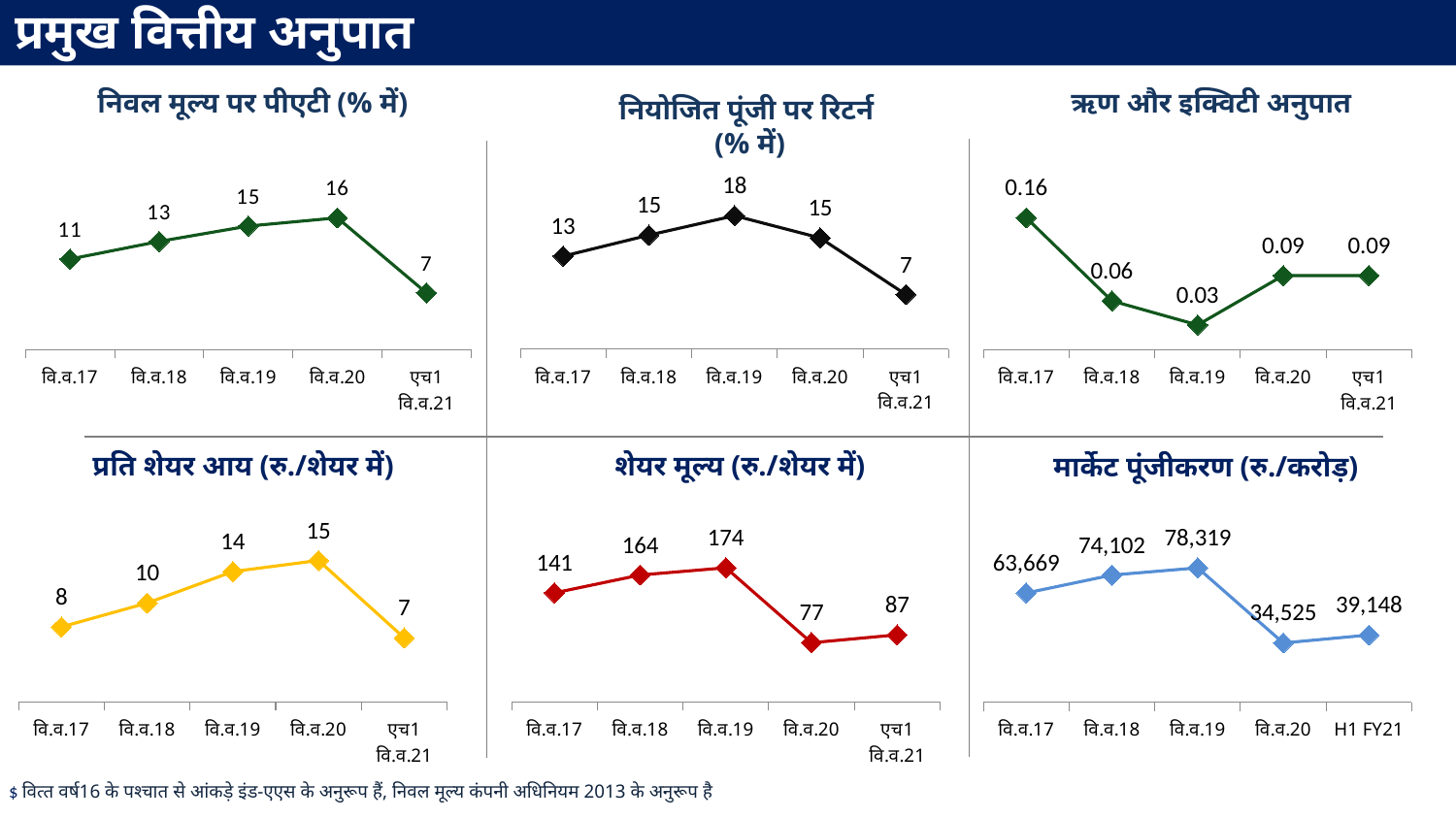
In the 'नियोजित पूंजी पर रिटर्न (% में)' chart, do the values rise or fall from वि.व.17 to वि.व.19? Rise In the 'शेयर मूल्य (रु./शेयर में)' chart, what is the value for वि.व.19? 174 In the 'नियोजित पूंजी पर रिटर्न (% में)' chart, which period has the highest value? वि.व.19 In the 'ऋण और इक्विटी अनुपात' chart, what is the value for वि.व.17? 0.16 What type of chart is the 'निवल मूल्य पर पीएटी (% में)' chart? Line chart In the 'मार्केट पूंजीकरण (रु./करोड़)' chart, what is the value for वि.व.19? 78,319 How many data points are plotted in the 'प्रति शेयर आय (रु./शेयर में)' chart? 5 In the 'शेयर मूल्य (रु./शेयर में)' chart, which is larger, the value for वि.व.20 or एच1 वि.व.21? एच1 वि.व.21 In the 'निवल मूल्य पर पीएटी (% में)' chart, what is the value for वि.व.20? 16 In the 'प्रति शेयर आय (रु./शेयर में)' chart, what is the difference between the values for वि.व.20 and एच1 वि.व.21? 8 In the 'ऋण और इक्विटी अनुपात' chart, which period has the lowest value? वि.व.19 In the 'मार्केट पूंजीकरण (रु./करोड़)' chart, what is the difference between the values for वि.व.18 and वि.व.17? 10,433